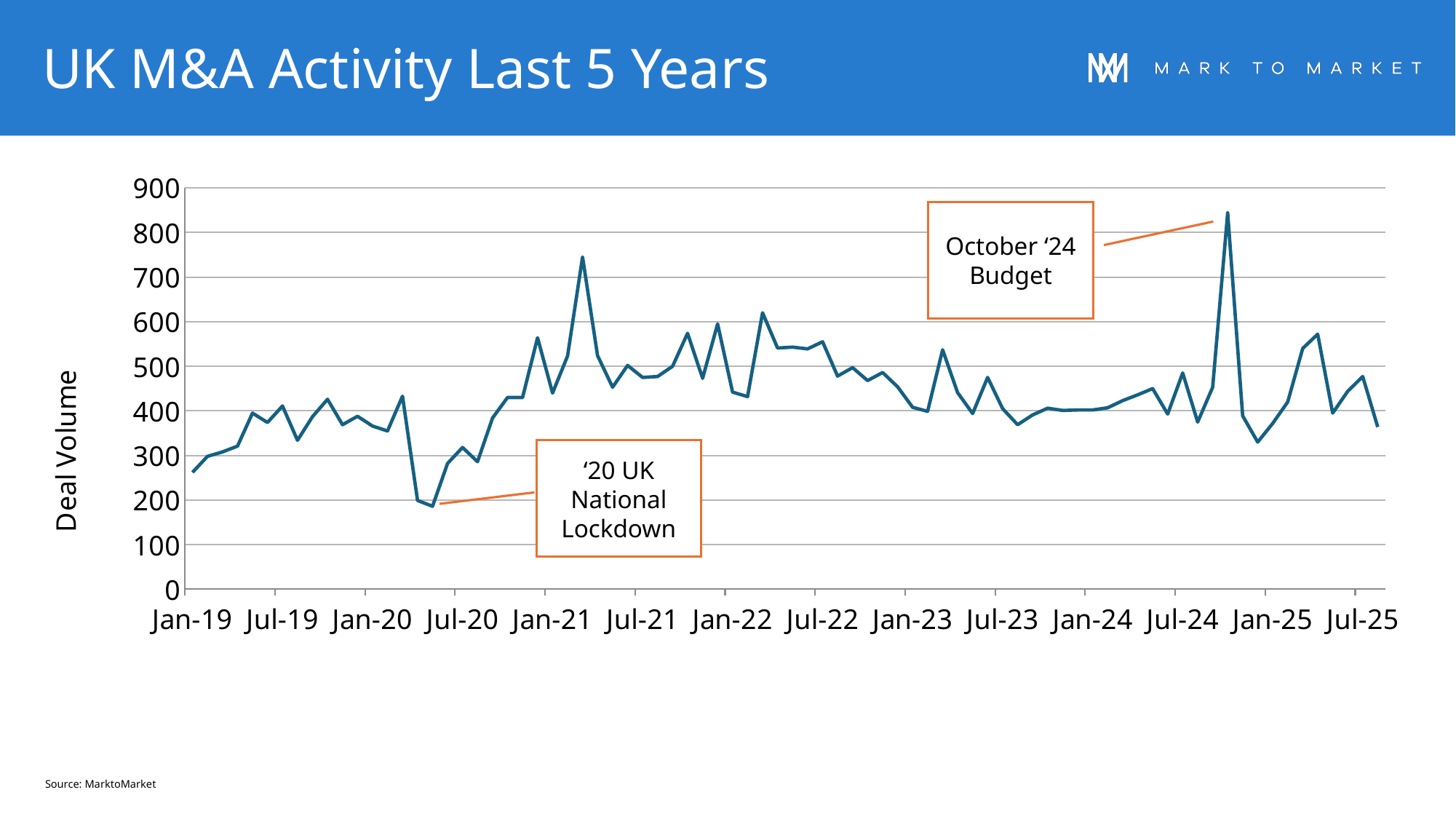
Which is larger: the peak in early 2021 or the peak in late 2024? The peak in late 2024 Is the peak deal volume near the October '24 Budget greater or less than 800? greater Does deal volume rise or fall between Jan-19 and Jul-19? rise Is the deal volume at Jan-19 greater or less than 300? less Which annotated event coincides with the highest point on the line? October '24 Budget Which annotated event coincides with the lowest point on the line? '20 UK National Lockdown Is the deal volume at Jan-25 greater or less than 400? less What is the title of the chart on the slide? UK M&A Activity Last 5 Years What is the label on the vertical axis of the chart? Deal Volume What kind of chart is shown on the slide? Line chart